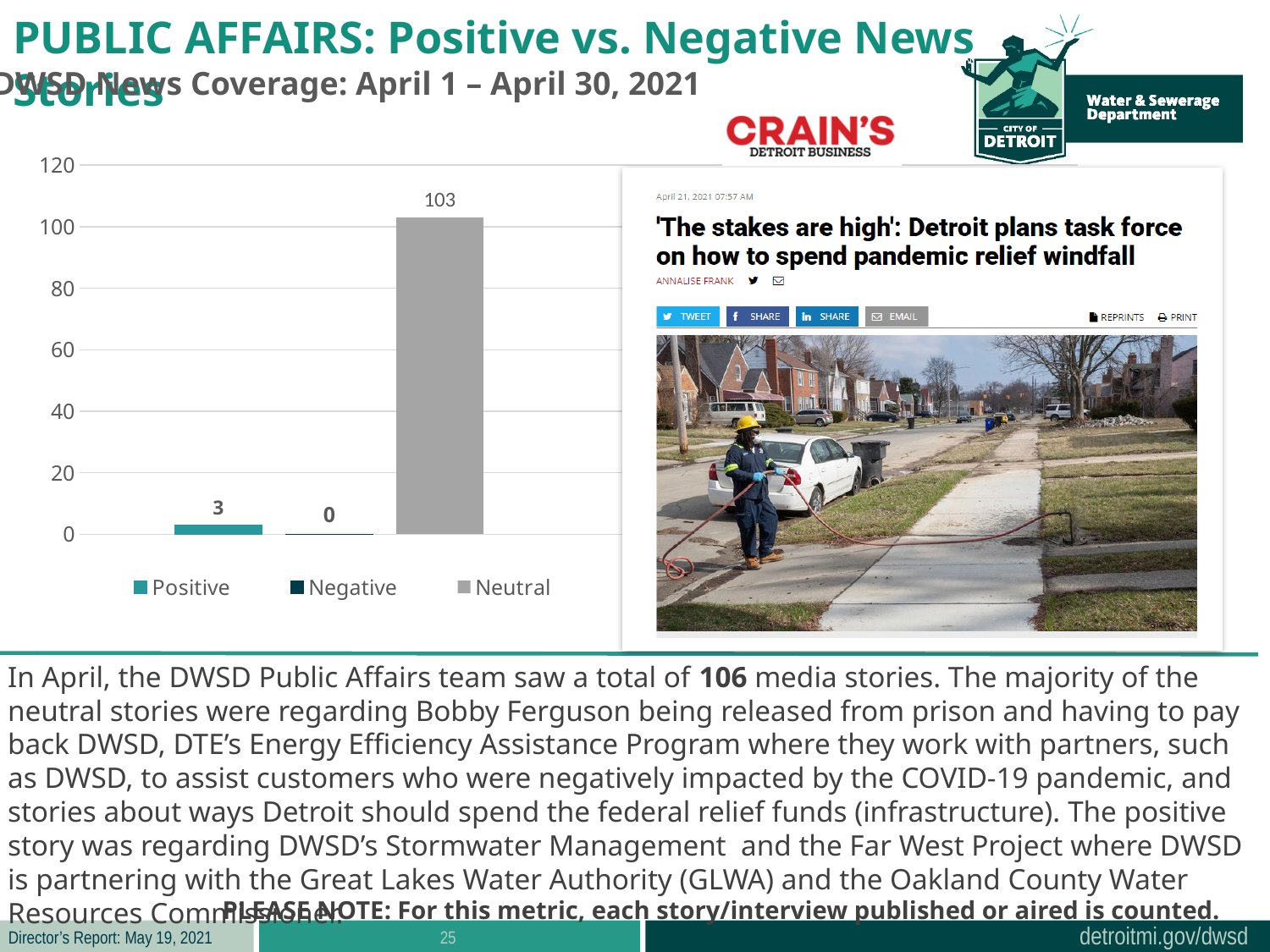
What is the difference between the Neutral and Positive values in the DWSD News Coverage chart? 100 How many series does the legend of the DWSD News Coverage chart list? 3 Is the value for Neutral in the DWSD News Coverage chart greater or less than 100? greater Which series has the lowest value in the DWSD News Coverage chart? Negative What is the highest value shown on the vertical axis of the DWSD News Coverage chart? 120 What is the value for Neutral in the DWSD News Coverage chart? 103 Which series has the highest value in the DWSD News Coverage chart? Neutral What is the value for Positive in the DWSD News Coverage chart? 3 Which is larger in the DWSD News Coverage chart, Positive or Negative? Positive What kind of chart is the DWSD News Coverage chart? bar chart What is the total of the three values shown in the DWSD News Coverage chart? 106 What is the value for Negative in the DWSD News Coverage chart? 0